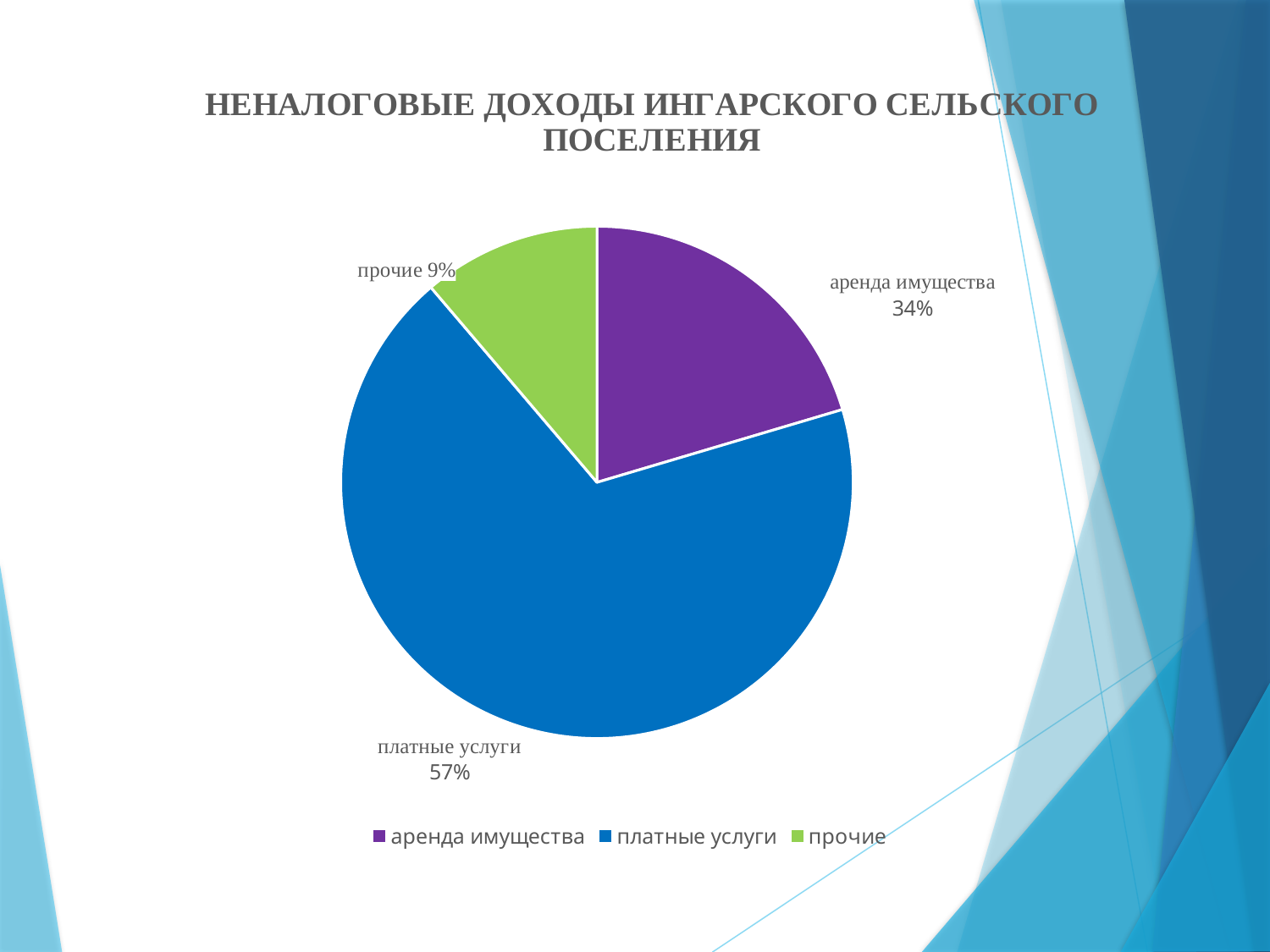
Which category has the smallest slice of the pie? прочие What is the title of the chart on the slide? НЕНАЛОГОВЫЕ ДОХОДЫ ИНГАРСКОГО СЕЛЬСКОГО ПОСЕЛЕНИЯ How many slices does the pie chart have? 3 What share of the pie does аренда имущества have? 34% What share of the pie does платные услуги have? 57% Which is larger, the slice for аренда имущества or the slice for прочие? аренда имущества What colour is the slice for платные услуги? blue What share of the pie does прочие have? 9% What kind of chart is shown on the slide? pie chart What is the difference in percentage points between аренда имущества and прочие? 25 Which category has the largest slice of the pie? платные услуги What is the difference in percentage points between платные услуги and аренда имущества? 23